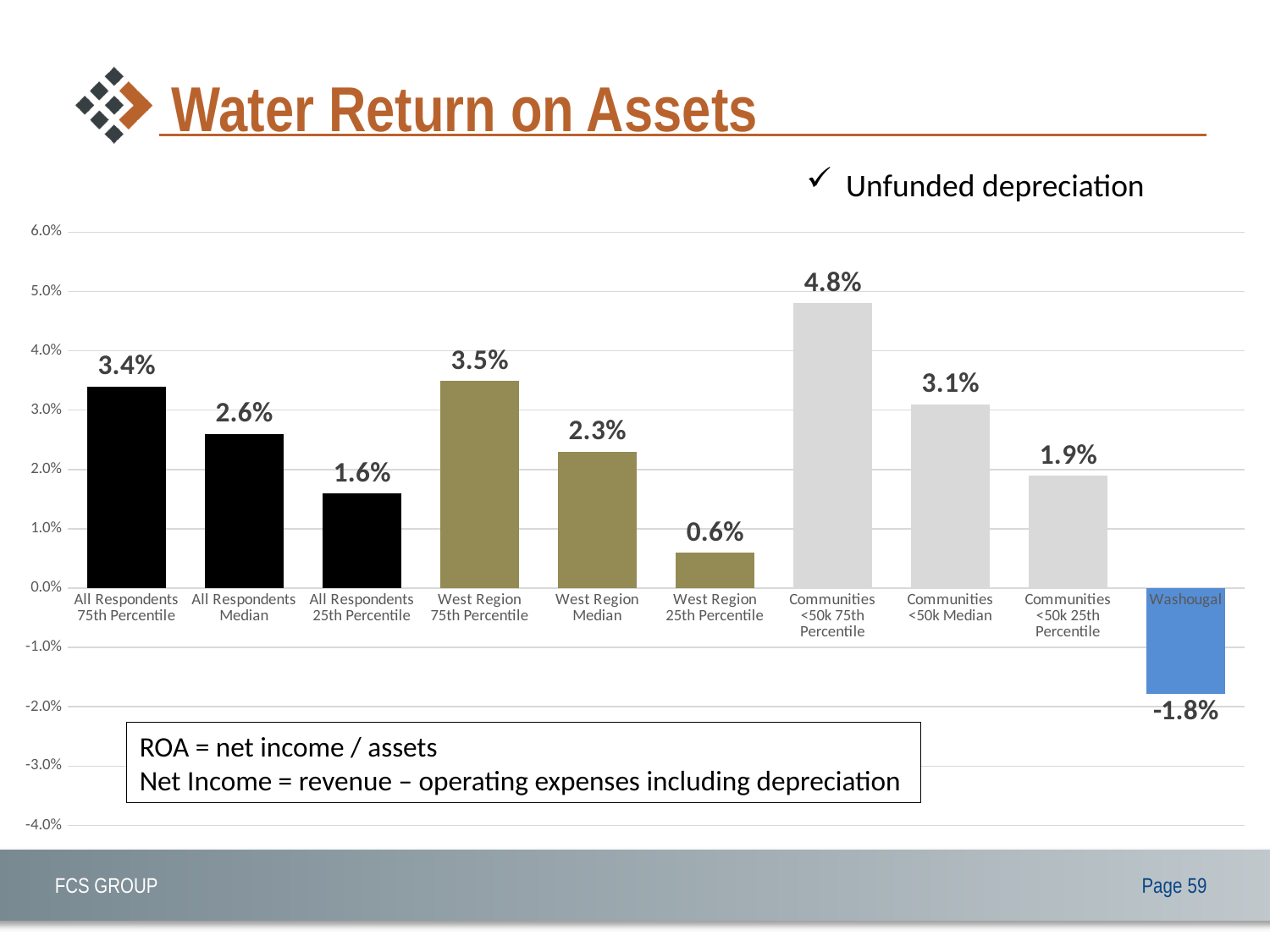
What kind of chart is shown on the slide? Bar chart What is the value for Washougal? -1.8% What is the value for Communities <50k 75th Percentile? 4.8% Which is larger, West Region 75th Percentile or All Respondents 75th Percentile? West Region 75th Percentile What is the difference between All Respondents 75th Percentile and All Respondents 25th Percentile? 1.8% What is the title of the slide containing the chart? Water Return on Assets What is the value for West Region Median? 2.3% Do the values fall from the 75th Percentile to the 25th Percentile within the West Region group? Yes, they fall Is the value for Communities <50k Median greater or less than 3.0%? greater Which category has the highest value? Communities <50k 75th Percentile How many categories are shown on the chart? 10 Which category has the lowest value? Washougal